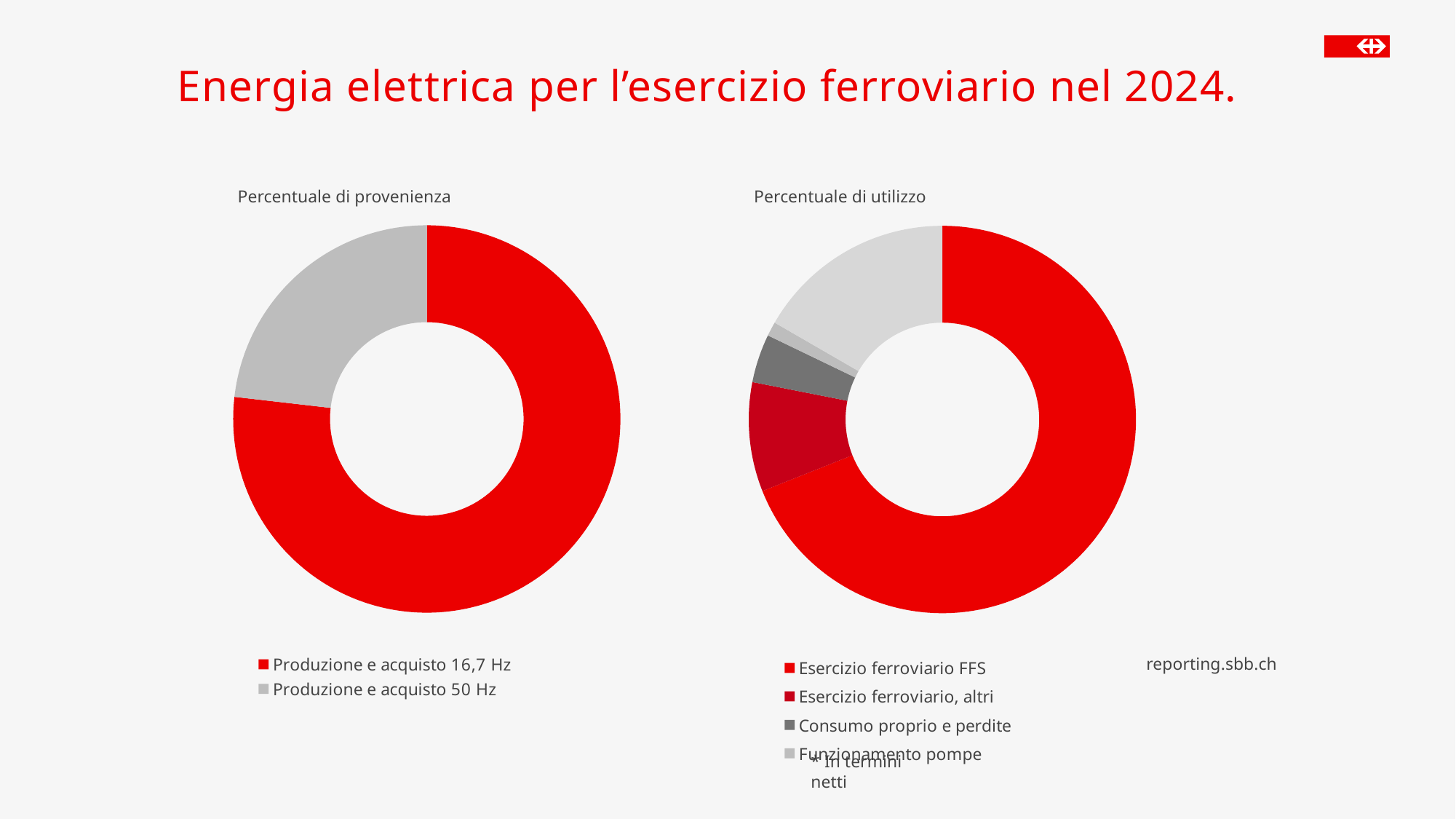
What kind of chart is the 'Percentuale di provenienza' chart? Pie chart (donut) In the 'Percentuale di utilizzo' chart, which is larger: 'Esercizio ferroviario FFS' or 'Consumo proprio e perdite'? Esercizio ferroviario FFS How many categories are shown in the 'Percentuale di provenienza' chart? 2 What is the title of the chart on the left of the slide? Percentuale di provenienza In the 'Percentuale di utilizzo' chart, which is larger: 'Esercizio ferroviario, altri' or 'Consumo proprio e perdite'? Esercizio ferroviario, altri In the 'Percentuale di provenienza' chart, which category has the smallest share? Produzione e acquisto 50 Hz What kind of chart is the 'Percentuale di utilizzo' chart? Pie chart (donut) In the 'Percentuale di provenienza' chart, which category has the largest share? Produzione e acquisto 16,7 Hz In the 'Percentuale di utilizzo' chart, what colour is the 'Esercizio ferroviario FFS' slice? Red In the 'Percentuale di provenienza' chart, is the share of 'Produzione e acquisto 16,7 Hz' greater or less than 50%? greater In the 'Percentuale di utilizzo' chart, which category has the largest share? Esercizio ferroviario FFS In the 'Percentuale di utilizzo' chart, is the share of 'Esercizio ferroviario FFS' greater or less than 50%? greater